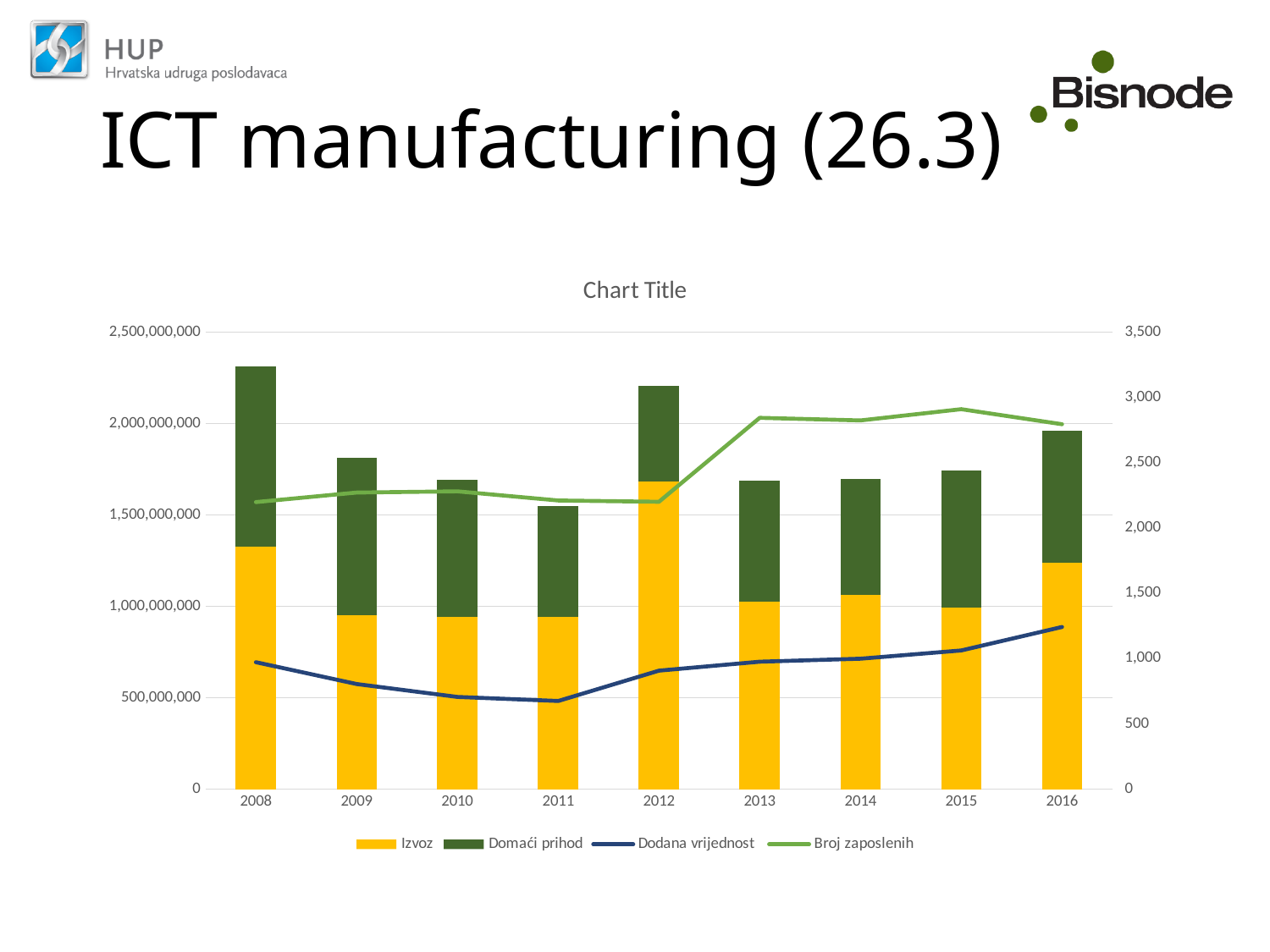
How many series does the chart legend list? 4 In which year is the total stacked bar (Izvoz plus Domaći prihod) the lowest? 2011 In which year is the Izvoz bar segment the largest? 2012 In which year is the total stacked bar (Izvoz plus Domaći prihod) the highest? 2008 Which year has the larger total stacked bar, 2012 or 2016? 2012 Does the Dodana vrijednost line rise or fall from 2011 to 2016? rises Is the Broj zaposlenih value for 2008 greater or less than 2,500 on the right axis? less Is the Izvoz value for 2009 greater or less than 1,000,000,000? less Is the Izvoz value for 2008 greater or less than 1,000,000,000? greater How many years are shown on the x axis of the chart? 9 What kind of chart is shown on the slide? bar chart with line series